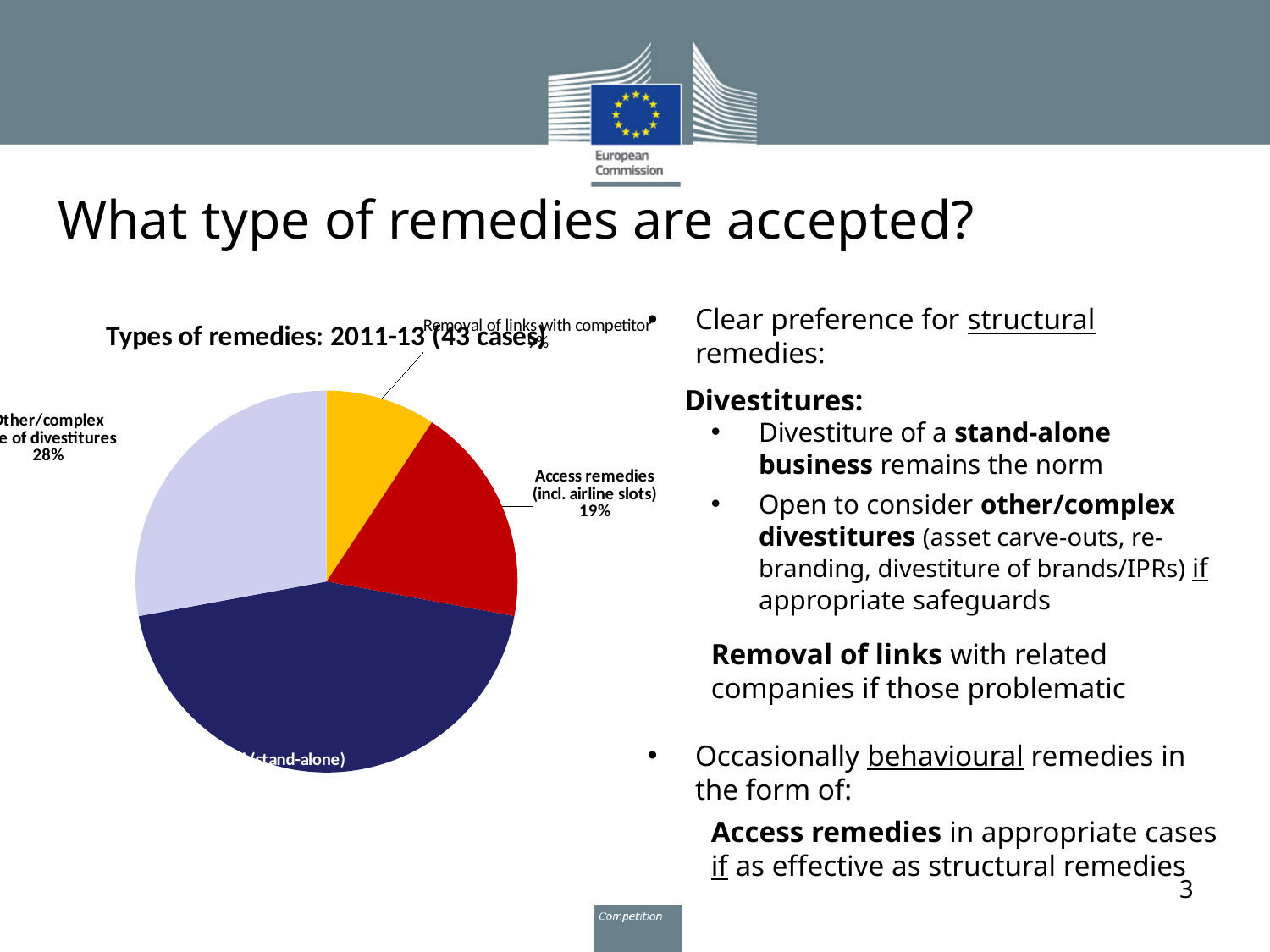
What share of the pie is Access remedies (incl. airline slots)? 19% What is the title of the chart? Types of remedies: 2011-13 (43 cases) What kind of chart is shown on the slide? Pie chart How many cases does the chart title say the data covers? 43 cases What is the difference in percentage points between Other/complex divestitures (28%) and Access remedies (19%)? 9 percentage points How many slices does the pie chart have? 4 Which slice of the pie is the smallest? Removal of links with competitor Which is larger: the share for Access remedies or the share for Other/complex divestitures? Other/complex divestitures What share of the pie is Other/complex divestitures? 28% Which is larger: the slice for Access remedies or the slice for Removal of links with competitor? Access remedies